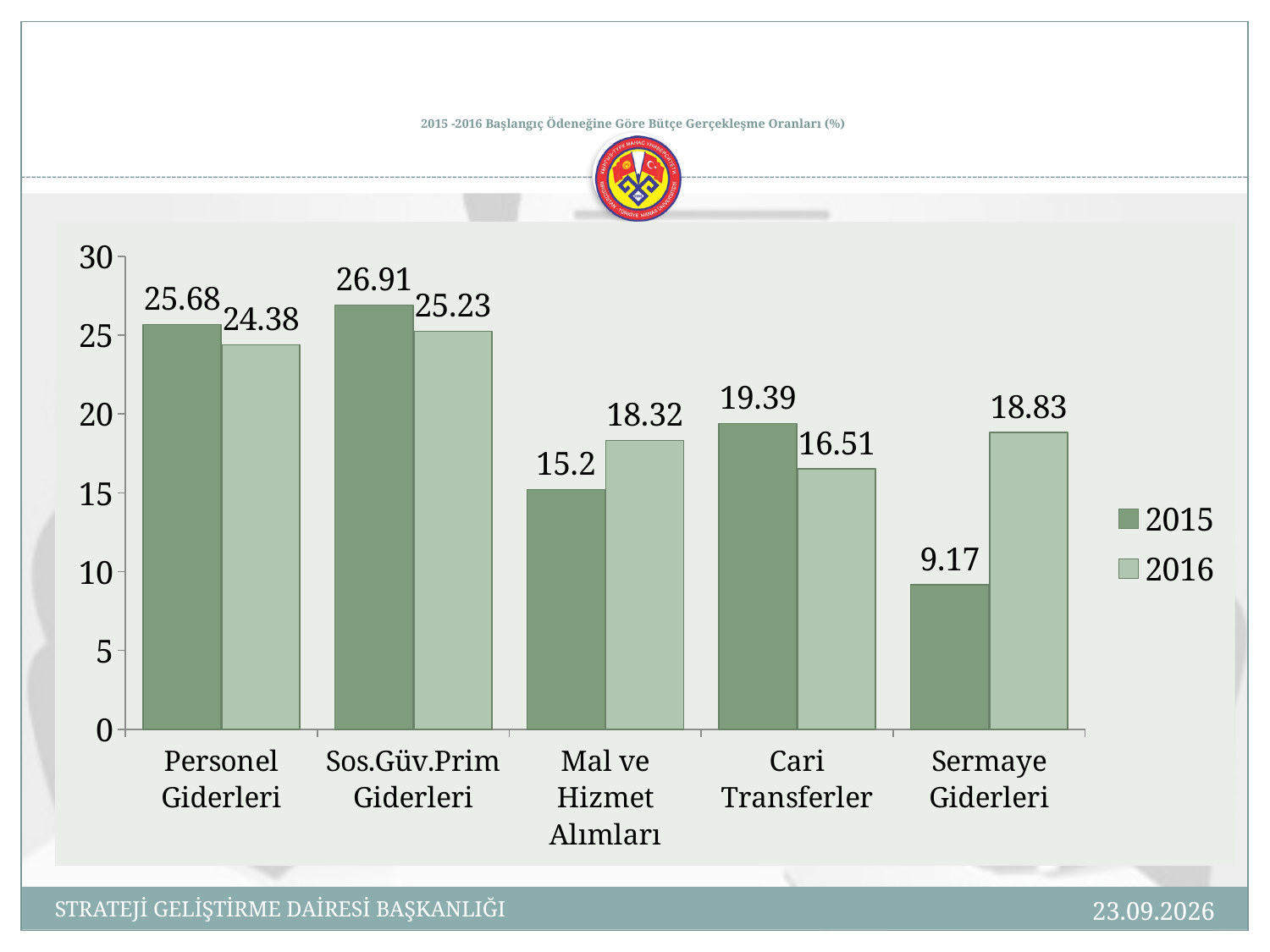
How many categories are shown on the x axis? 5 What is the difference between the 2015 and 2016 values for Sermaye Giderleri? 9.66 What kind of chart is shown on the slide? Bar chart How many series does the legend list? 2 For Mal ve Hizmet Alımları, which year has the larger value, 2015 or 2016? 2016 What is the 2016 value for Sermaye Giderleri? 18.83 Which category has the lowest 2016 value? Cari Transferler What is the 2016 value for Mal ve Hizmet Alımları? 18.32 Which category has the lowest 2015 value? Sermaye Giderleri What is the difference between the 2015 and 2016 values for Cari Transferler? 2.88 Which category has the highest 2015 value? Sos.Güv.Prim Giderleri What is the 2015 value for Personel Giderleri? 25.68